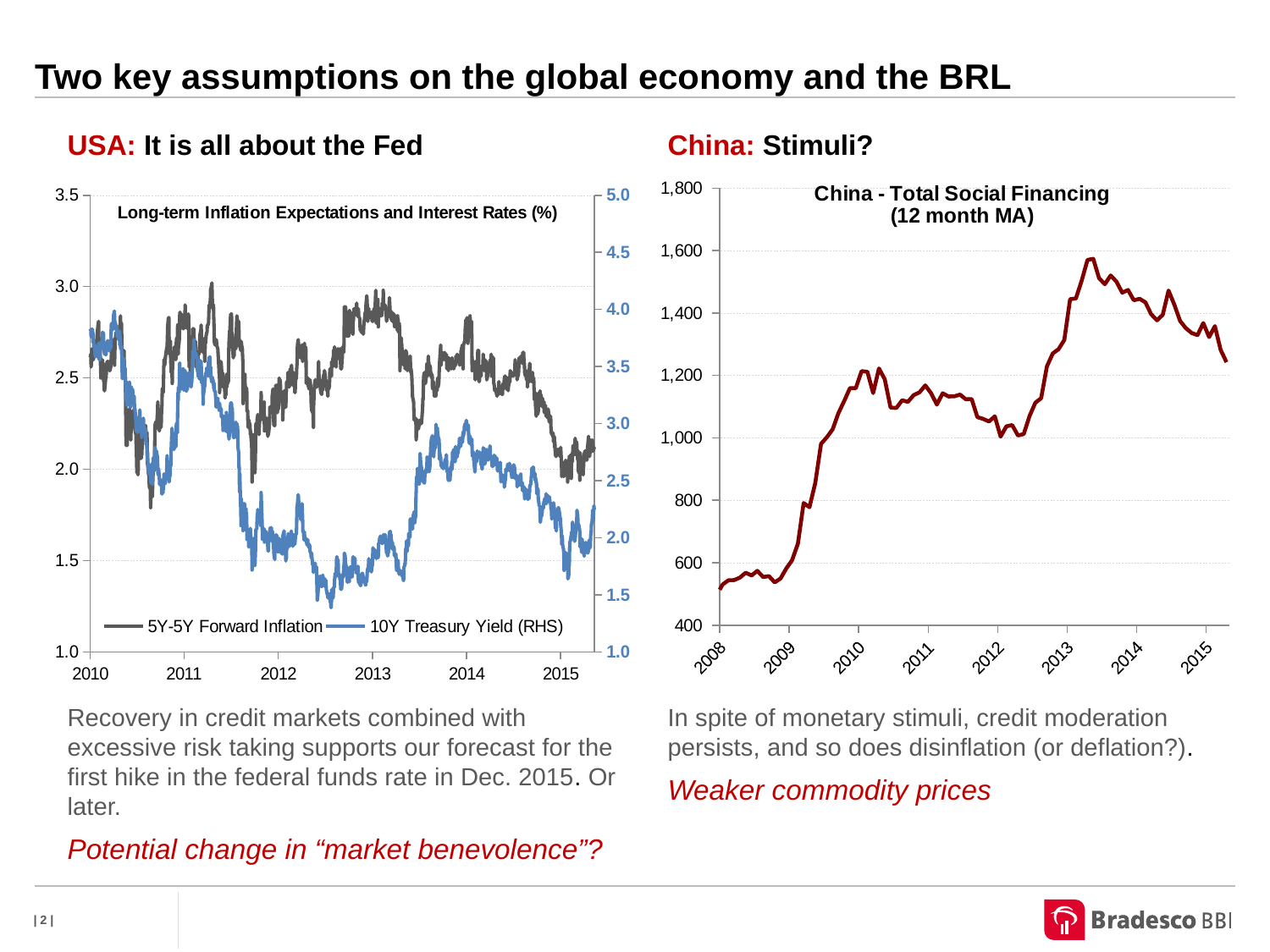
In the China - Total Social Financing chart, is the peak value in 2013 greater or less than 1,400? greater In the China - Total Social Financing chart, in which year does the series reach its highest point? 2013 In the left chart, is the 10Y Treasury Yield at the start of 2010 greater or less than 3.0? greater In the left chart, is the 10Y Treasury Yield in mid-2012 greater or less than 2.0? less What kind of chart is the left chart titled "Long-term Inflation Expectations and Interest Rates (%)"? Line chart What kind of chart is the right chart titled "China - Total Social Financing (12 month MA)"? Line chart In the left chart, does the 5Y-5Y Forward Inflation series rise or fall between 2014 and 2015? Fall In the China - Total Social Financing chart, does the series rise or fall between 2008 and 2010? Rise How many series does the legend of the left chart (Long-term Inflation Expectations and Interest Rates) list? 2 In the left chart, which series is plotted against the right-hand axis? 10Y Treasury Yield (RHS)